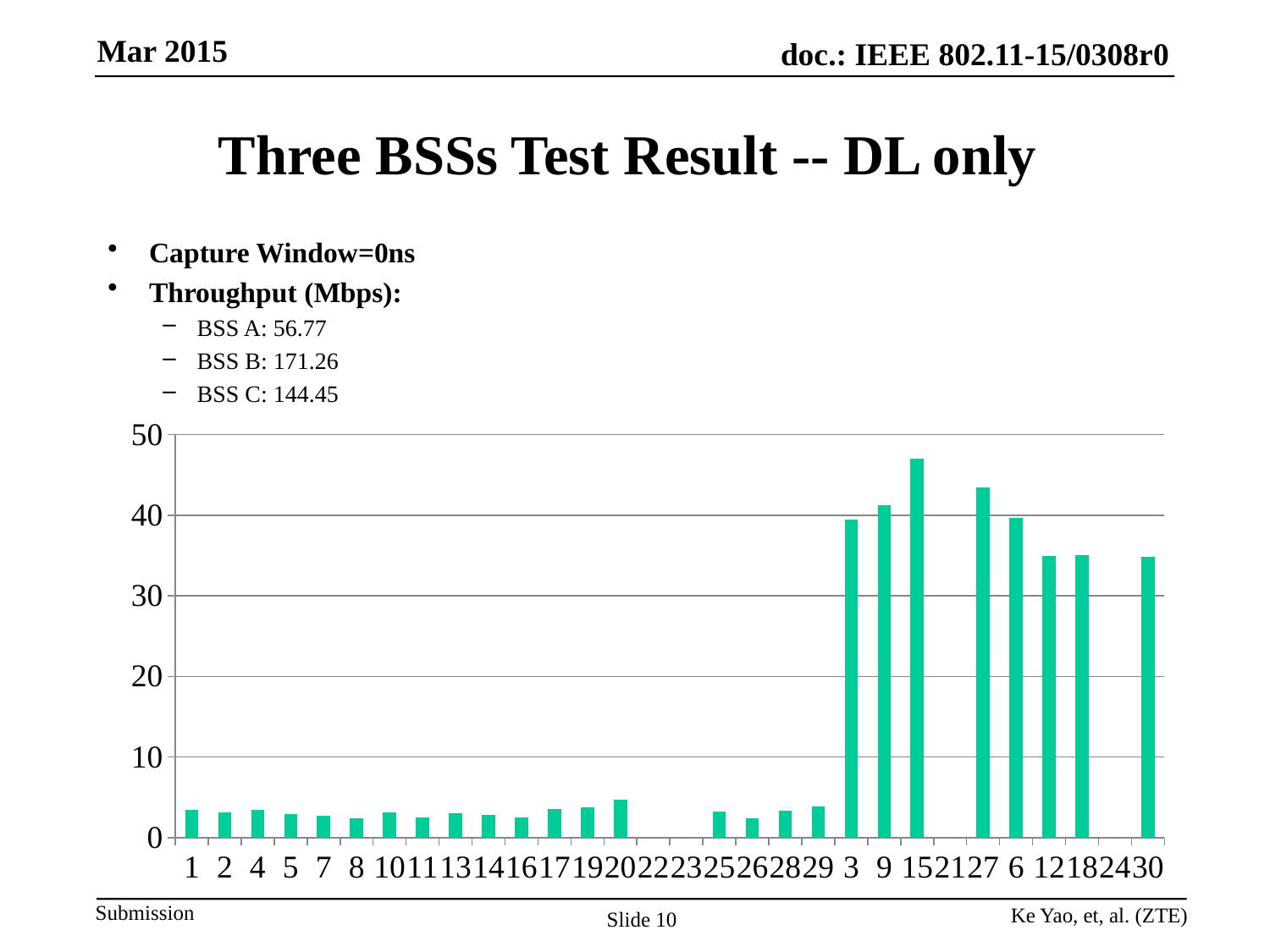
How many categories are shown along the x axis of the chart? 30 What kind of chart is shown on the slide? bar chart Is the value for category 30 greater or less than 30? greater Is the value for category 27 greater or less than 40? greater Is the value for category 1 greater or less than 10? less Which is larger, the value for category 27 or the value for category 12? 27 Which is larger, the value for category 15 or the value for category 1? 15 Which category has the highest bar in the chart? 15 What is the highest tick value shown on the y axis of the chart? 50